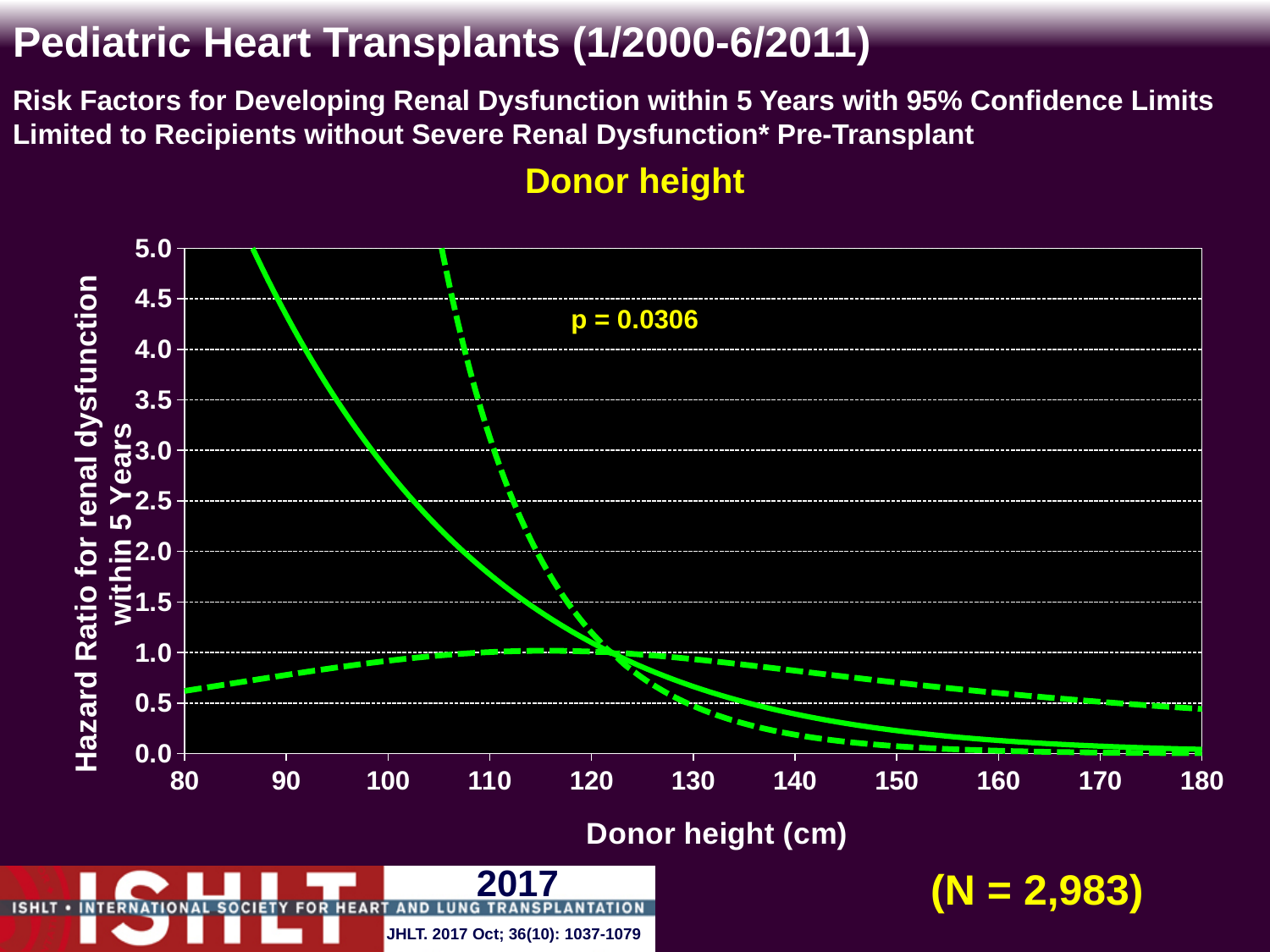
Is the lower 95% confidence limit (lower dashed line) at a donor height of 80 cm greater or less than 1.0? less Is the upper 95% confidence limit (upper dashed line) at a donor height of 100 cm greater or less than 4.0? greater Is the hazard ratio (solid line) at a donor height of 140 cm greater or less than 1.0? less What kind of chart is shown on the slide? line chart What p-value is printed on the chart? p = 0.0306 As donor height increases along the x axis, does the hazard ratio for renal dysfunction (solid line) rise or fall? fall Which donor height has the larger hazard ratio on the solid line, 90 cm or 150 cm? 90 cm What is the label of the x axis? Donor height (cm) How many lines are plotted on the chart? 3 What sample size (N) is shown on the slide? N = 2,983